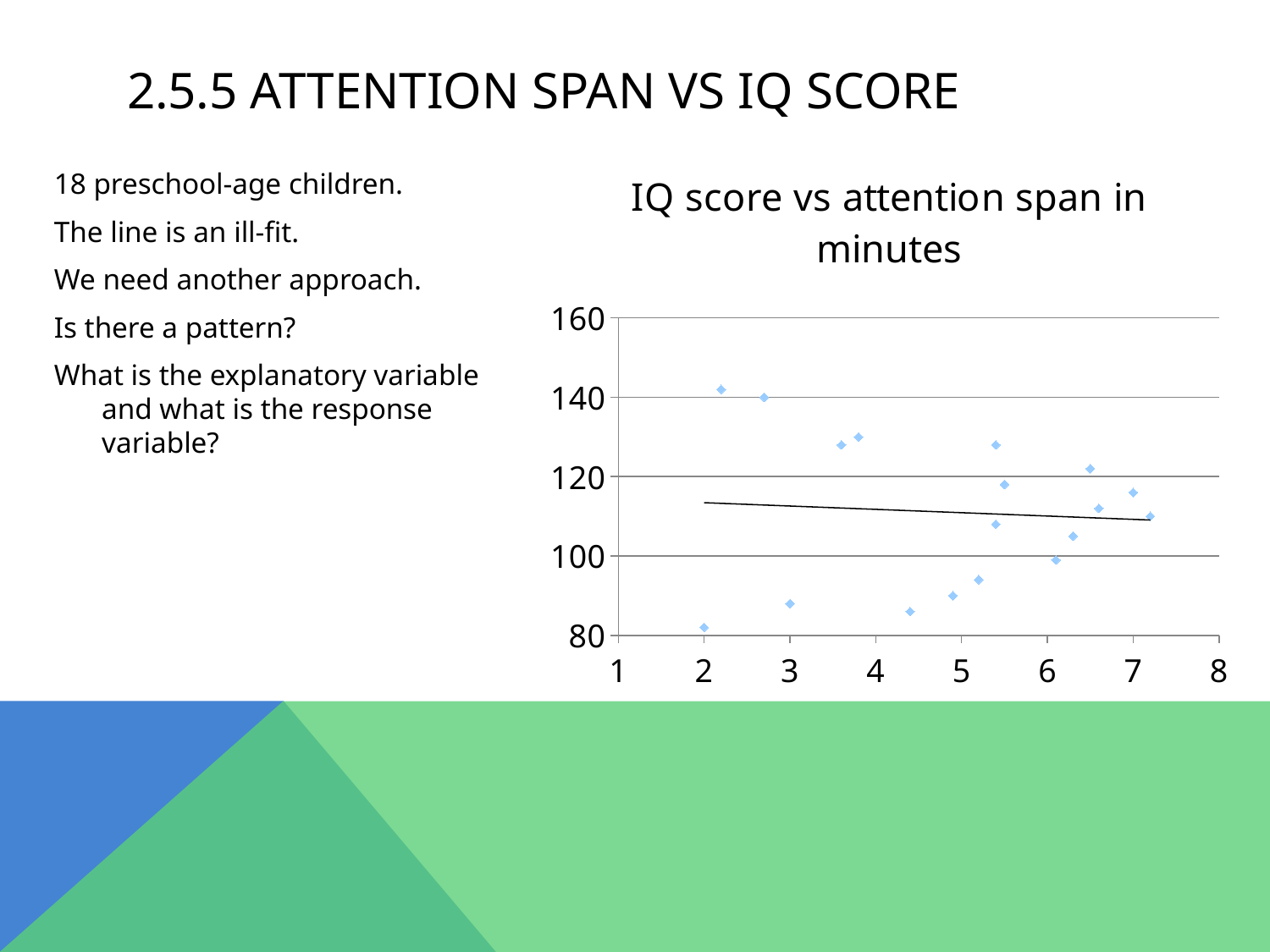
What kind of chart is shown on the slide? scatter plot Is the value of the highest plotted point greater or less than 140? greater What is the highest value shown on the vertical axis? 160 Does the fitted line rise or fall as the x value increases? falls How many data points are plotted in the scatter plot? 18 Is the value of the point at x = 7 greater or less than 100? greater Is the fitted line above or below 100 across the plotted range? above What is the title of the chart? IQ score vs attention span in minutes Which has the larger y value: the point at x = 2.2 or the point at x = 2.0? the point at x = 2.2